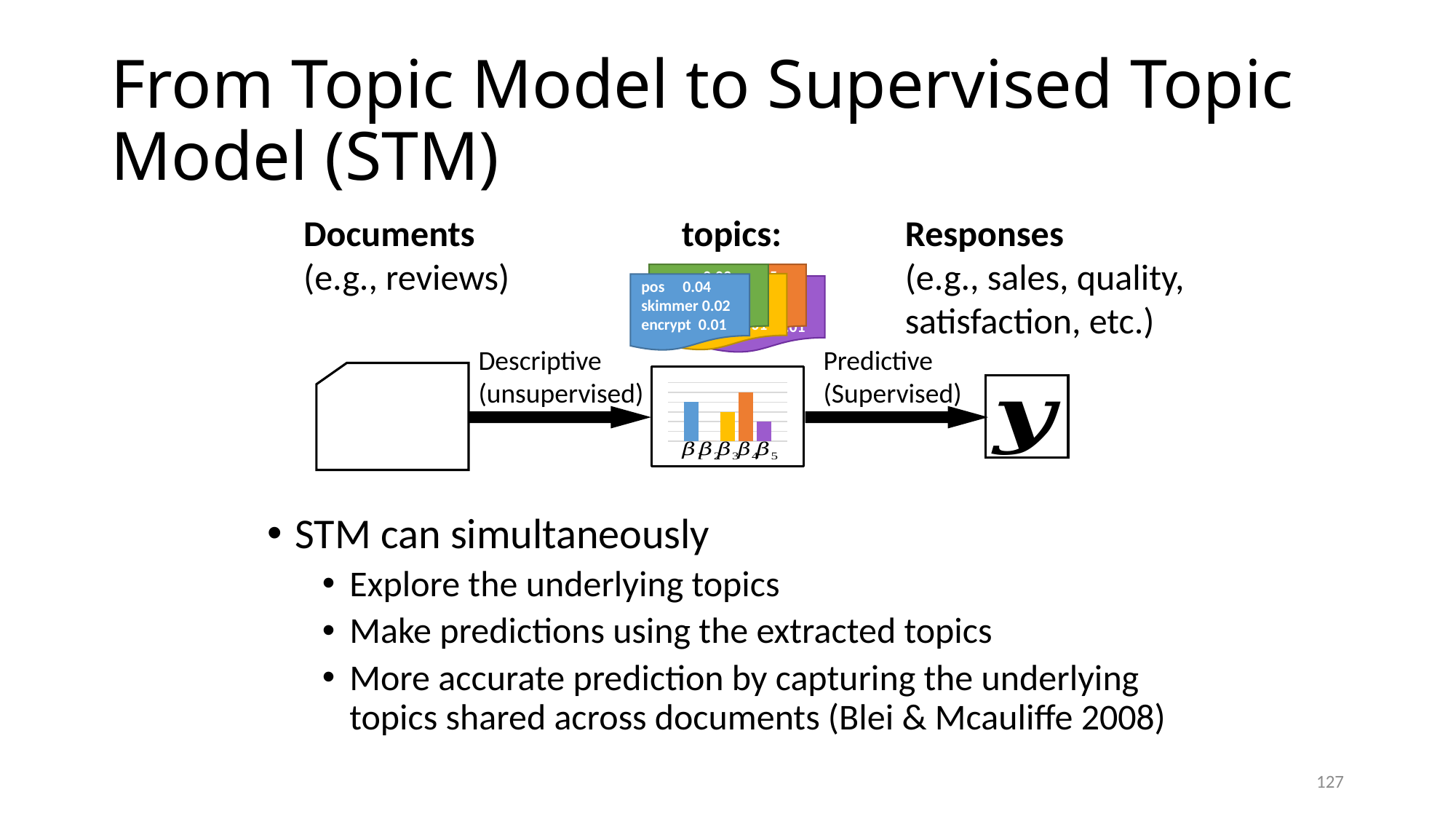
In the bar chart in the middle of the diagram, which is taller, the orange bar or the purple bar? orange In the bar chart in the middle of the diagram, are the bars vertical or horizontal? vertical In the bar chart in the middle of the diagram, what Greek letter is used to label the categories on the x axis? β In the bar chart in the middle of the diagram, which coloured bar is the tallest? orange In the bar chart in the middle of the diagram, which coloured bar is the shortest? purple What kind of chart is shown in the middle of the diagram (between the document and the y box)? bar chart In the bar chart in the middle of the diagram, which is taller, the yellow bar or the orange bar? orange In the bar chart in the middle of the diagram, which is taller, the blue bar or the yellow bar? blue